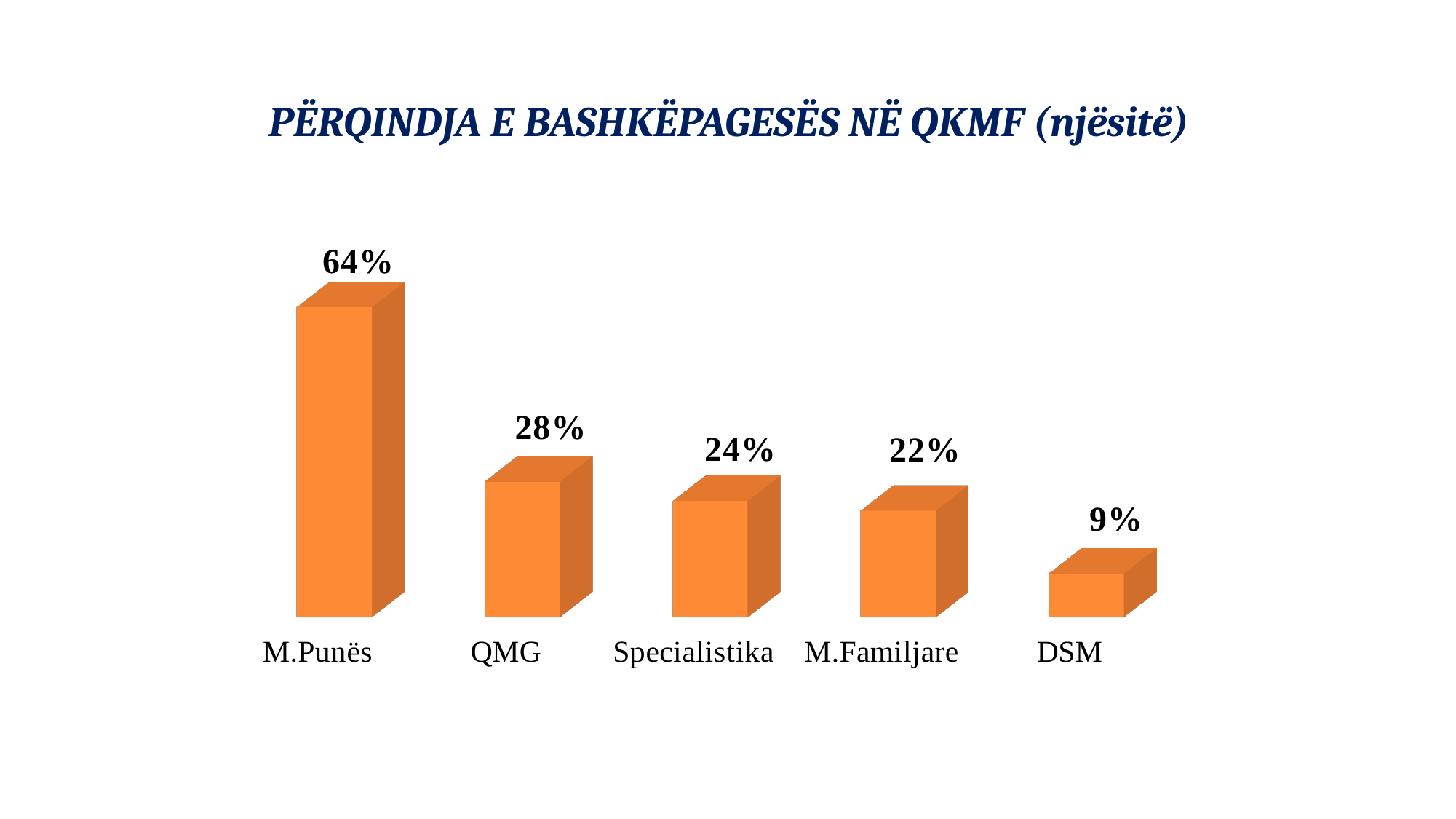
What is the value for Specialistika? 24% What is the value for DSM? 9% Which category has the lowest value? DSM What is the value for M.Punës? 64% Which category has the highest value? M.Punës What kind of chart is shown on the slide? Bar chart How many categories are shown in the chart? 5 What is the value for QMG? 28% What is the difference between the values for M.Punës and QMG? 36% What is the title of the chart? PËRQINDJA E BASHKËPAGESËS NË QKMF (njësitë) Which is larger, the value for Specialistika or the value for M.Familjare? Specialistika What is the value for M.Familjare? 22%